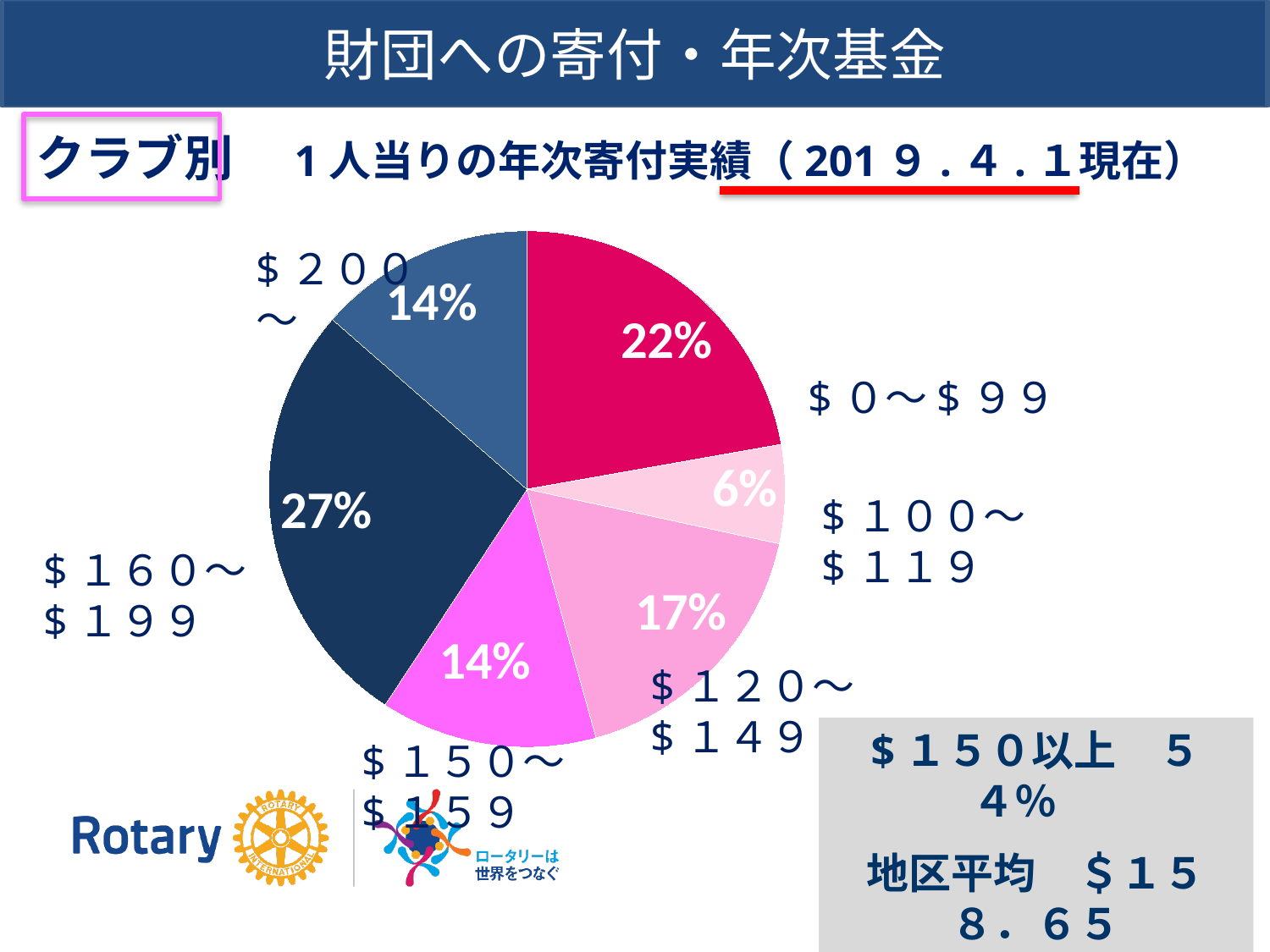
What percentage is shown for the $120〜$149 slice? 17% What percentage is shown for the $160〜$199 slice? 27% Which category has the smallest share of the pie? $100〜$119 What share of the pie does the $0〜$99 slice represent? 22% How many slices does the pie chart have? 6 What is the combined percentage of the $150〜$159 and $200〜 slices? 28% What is the district average (地区平均) stated in the box on the slide? $158.65 What is the difference in percentage points between the $160〜$199 slice and the $0〜$99 slice? 5 Which category has the largest share of the pie? $160〜$199 What percentage is shown for the $100〜$119 slice? 6% What kind of chart is shown on the slide? pie chart Which is larger, the $120〜$149 slice or the $150〜$159 slice? $120〜$149